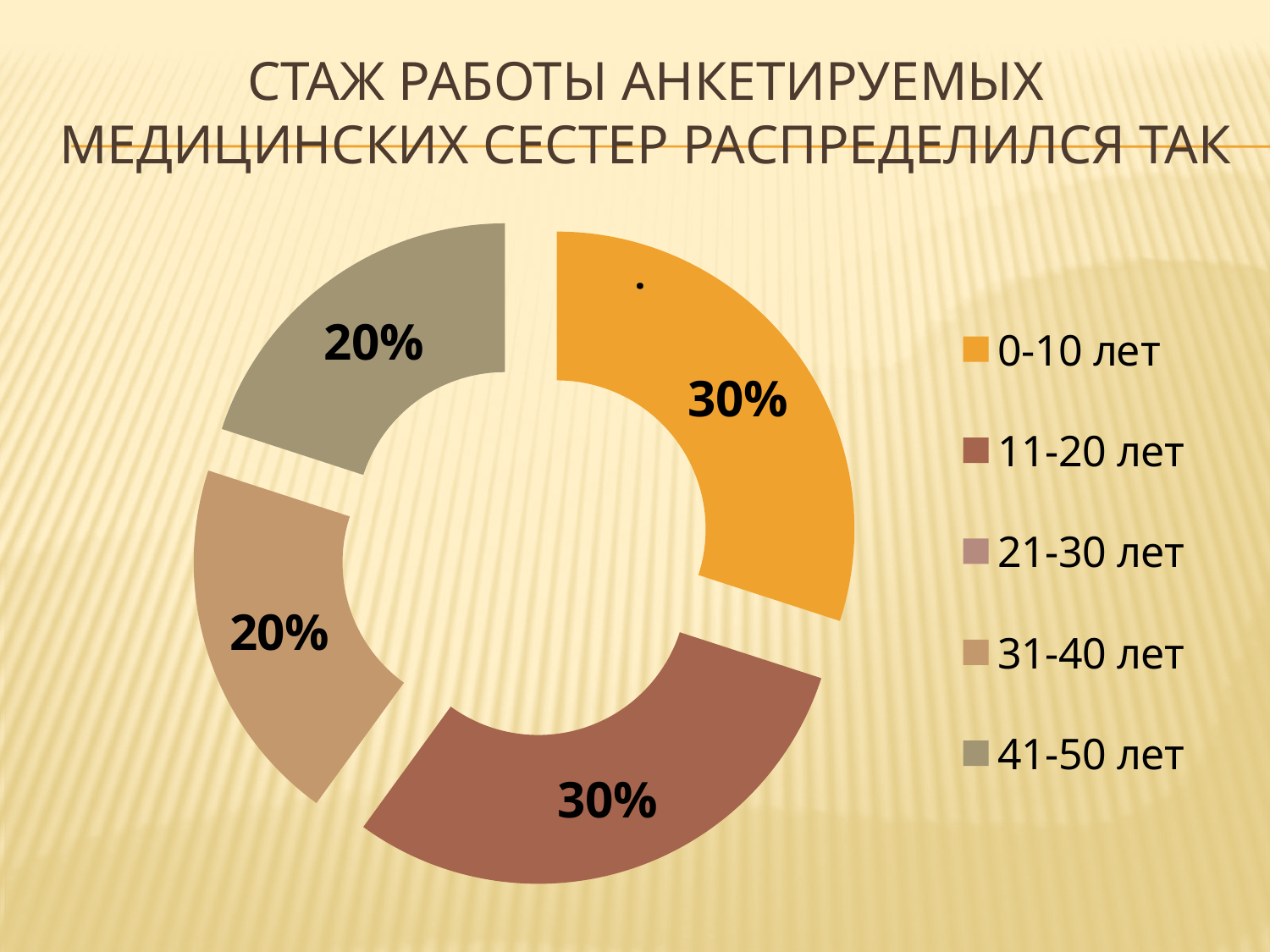
What colour is the slice for 0-10 лет? Orange What percentage of respondents fall into the 41-50 лет group? 20% How many slices with data labels are plotted in the chart? 4 Which legend category has no visible slice in the chart? 21-30 лет What kind of chart is shown on the slide? Doughnut (pie) chart Which is larger, the share for 0-10 лет or the share for 31-40 лет? 0-10 лет How many categories does the legend list? 5 What percentage is shown for the 11-20 лет category? 30% Which is larger, the share for 41-50 лет or the share for 11-20 лет? 11-20 лет What is the difference in percentage points between the 11-20 лет slice and the 41-50 лет slice? 10 What share of the surveyed nurses have 0-10 years of work experience (0-10 лет)? 30% What value is labelled on the 31-40 лет slice? 20%